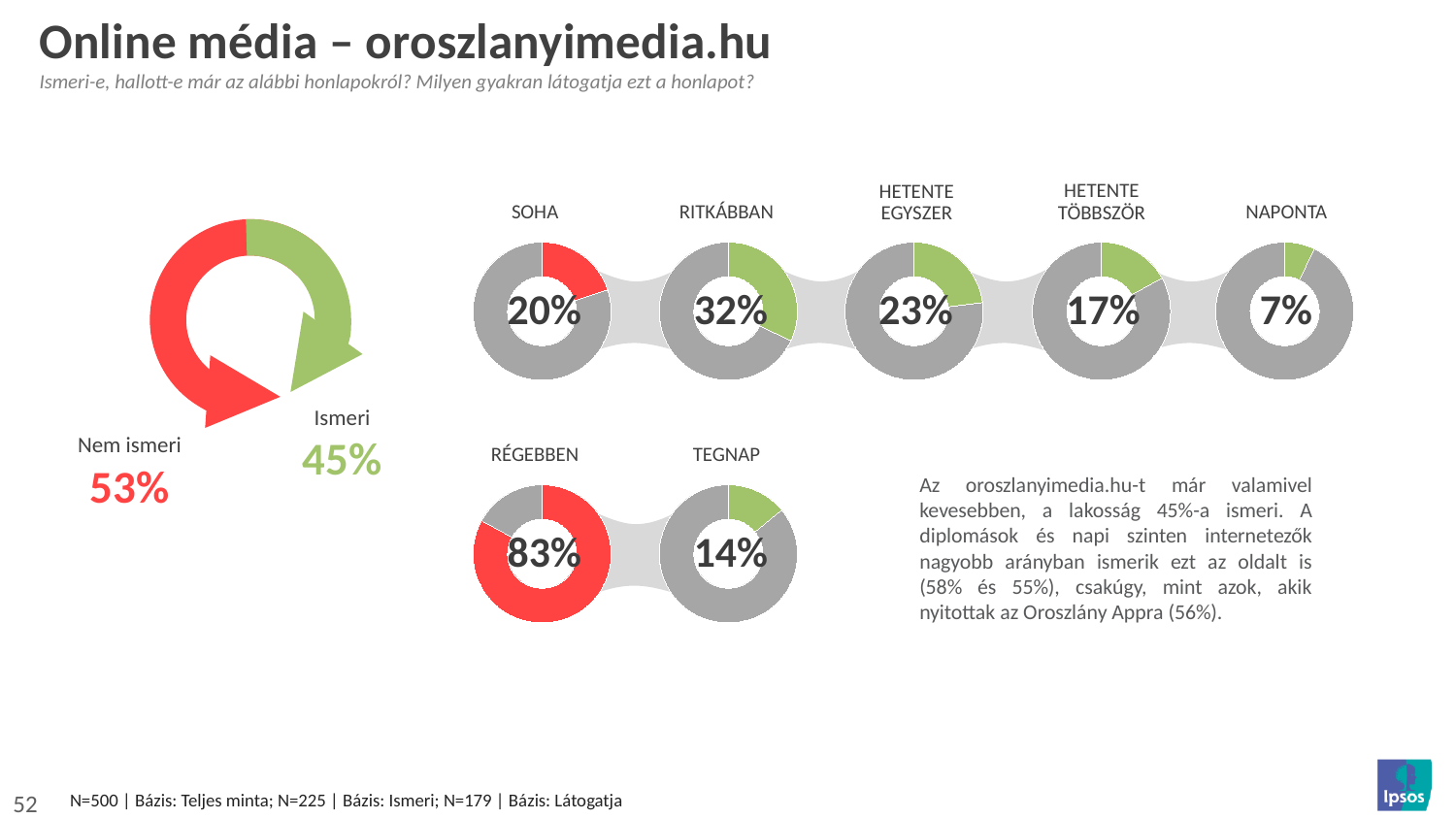
On the large donut chart on the left, what is the difference between "Nem ismeri" and "Ismeri"? 8 percentage points In the row of five small donut charts at the top, which category has the lowest percentage? NAPONTA On the large donut chart on the left, what percentage is shown for "Ismeri"? 45% In the pair of small donut charts in the lower middle, what percentage is shown for "TEGNAP"? 14% How many small donut charts are in the top row (SOHA to NAPONTA)? 5 On the large donut chart on the left, which is larger, "Nem ismeri" or "Ismeri"? Nem ismeri In the row of five small donut charts at the top, what percentage is shown for "SOHA"? 20% In the row of five small donut charts at the top, which category has the highest percentage? RITKÁBBAN In the row of five small donut charts at the top, what is the difference between "RITKÁBBAN" and "HETENTE EGYSZER"? 9 percentage points On the large donut chart on the left, what percentage is shown for "Nem ismeri"? 53% In the row of five small donut charts at the top, what percentage is shown for "HETENTE TÖBBSZÖR"? 17% In the pair of small donut charts in the lower middle, what percentage is shown for "RÉGEBBEN"? 83%